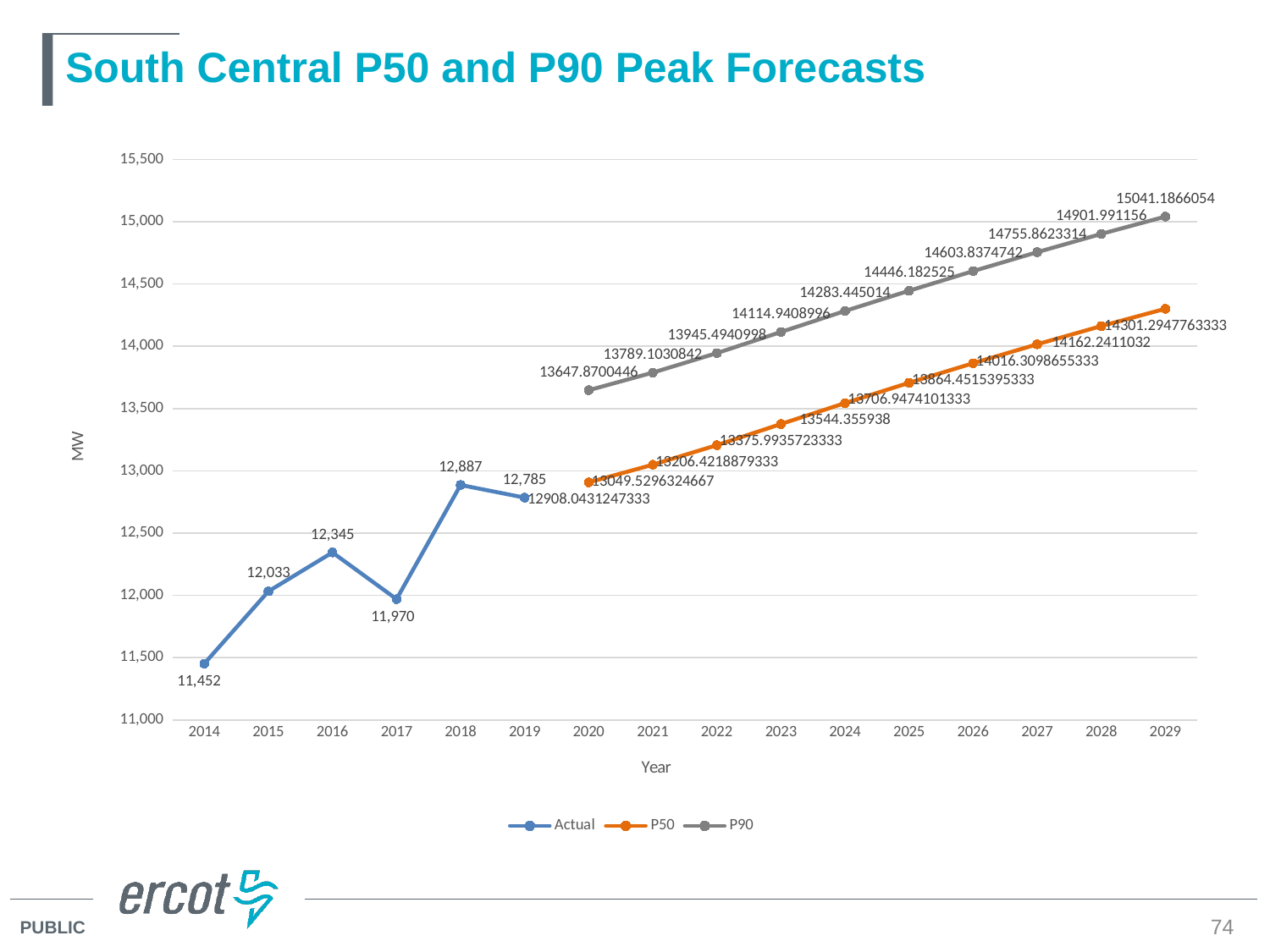
What is the Actual value for 2018? 12,887 How many years are shown on the x axis? 16 What type of chart is shown on the slide? Line chart What is the difference between the Actual values for 2018 and 2017? 917 In which year is the Actual series lowest? 2014 What is the P50 value for 2029? 14301.2947763333 How many series does the legend list? 3 Does the P90 series rise or fall from 2020 to 2029? Rise What is the P90 value for 2029? 15041.1866054 What is the Actual value for 2014? 11,452 In which year is the Actual series highest? 2018 Which year has the larger Actual value, 2015 or 2017? 2015